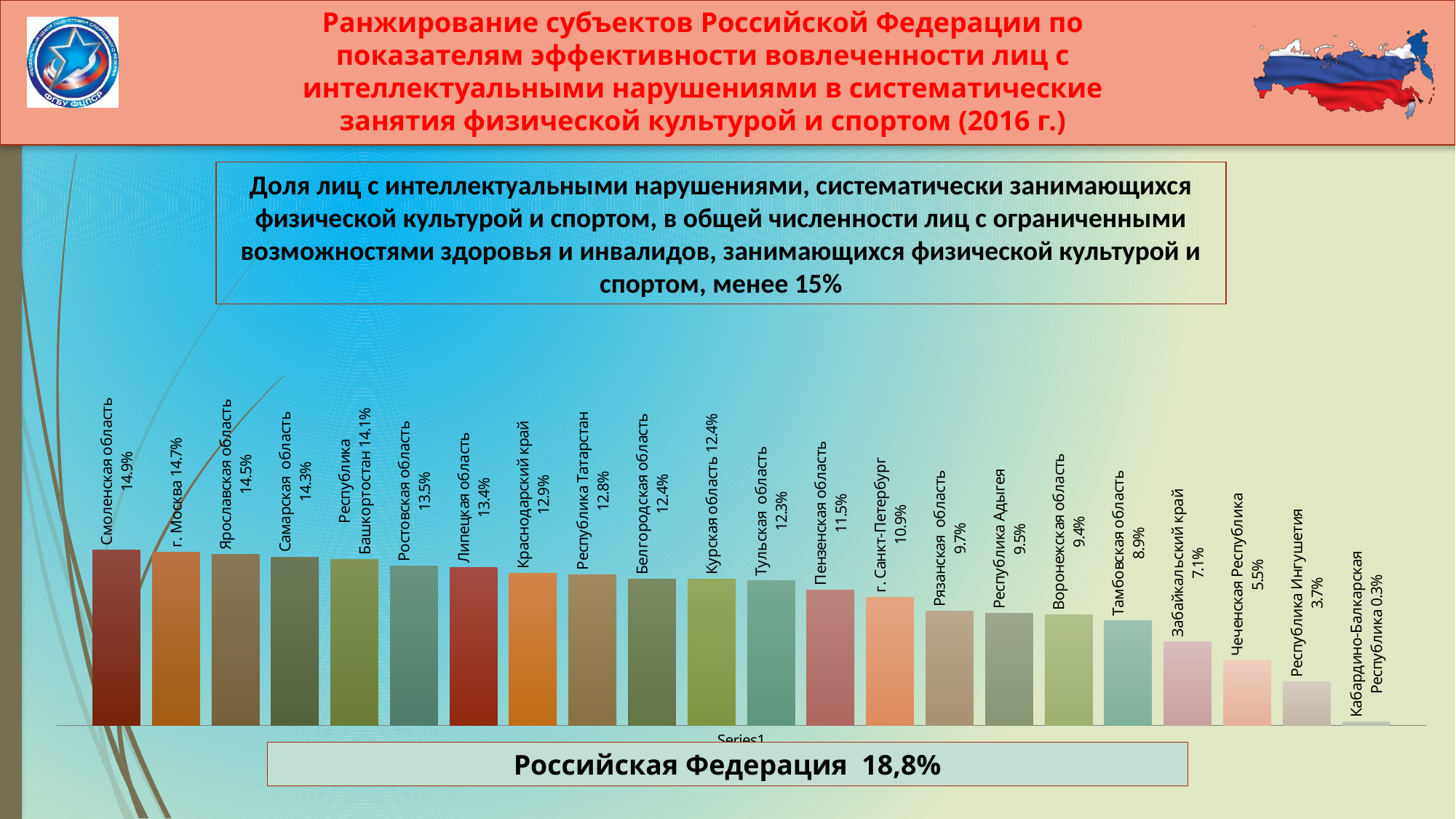
What is the value shown for г. Санкт-Петербург? 10.9% What is the value shown for Республика Ингушетия? 3.7% Which has the larger value, Краснодарский край or Забайкальский край? Краснодарский край Do the values rise or fall moving from left to right along the x axis? fall What is the value shown for Смоленская область? 14.9% Which region has the highest value in the chart? Смоленская область Which region has the lowest value in the chart? Кабардино-Балкарская Республика What is the value shown for Тамбовская область? 8.9% How many regions (bars) are plotted in the chart? 22 What value is given for Российская Федерация in the box below the chart? 18,8% What type of chart is shown on the slide? bar chart What is the difference between the values for Смоленская область and Кабардино-Балкарская Республика? 14.6 percentage points